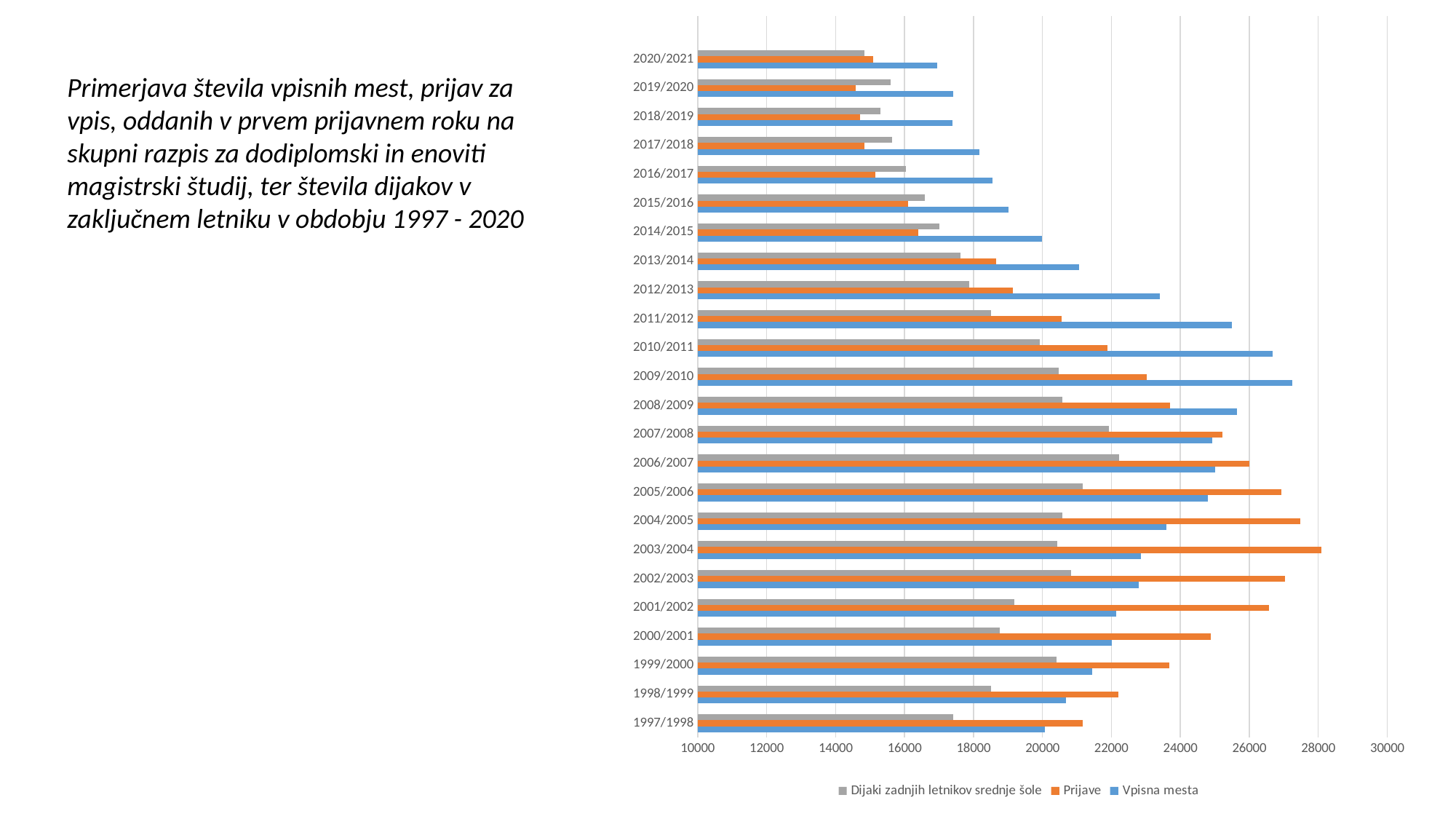
Is the value for Prijave in 2003/2004 greater or less than 26000? greater Which academic year has the highest value for Prijave? 2003/2004 In 2003/2004, which is larger: Prijave or Vpisna mesta? Prijave Is the value for Vpisna mesta in 2009/2010 greater or less than 26000? greater Is the value for Vpisna mesta in 2020/2021 greater or less than 18000? less What kind of chart is shown on the slide? bar chart In 2010/2011, which is larger: Vpisna mesta or Prijave? Vpisna mesta How many series does the legend list? 3 Which colour represents the Prijave series in the legend? orange From 2009/2010 to 2020/2021, do the values for Vpisna mesta rise or fall? fall How many academic years (categories) are plotted on the chart? 24